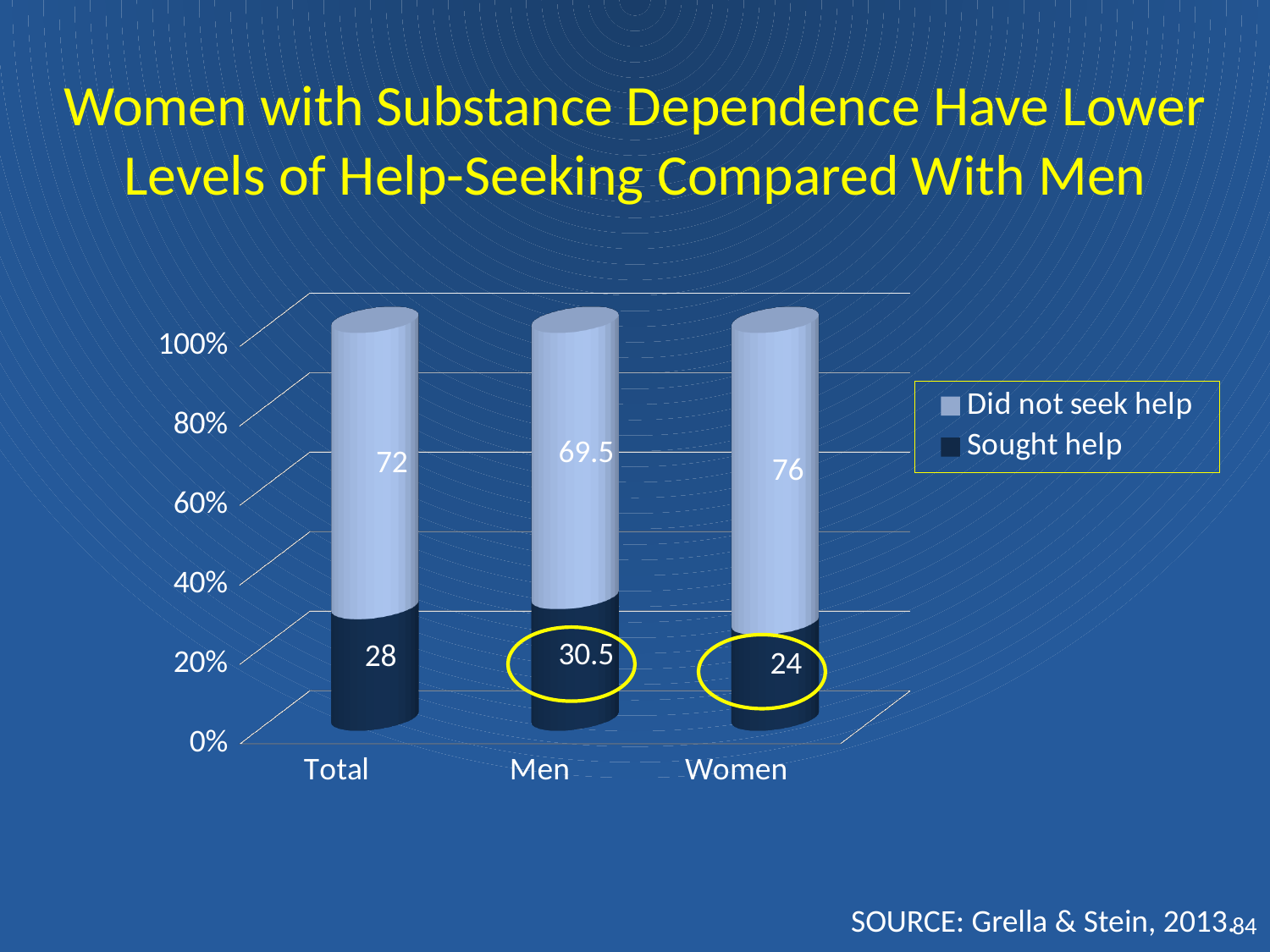
Which category has the highest value for Sought help? Men What is the difference between the Sought help values for Men and Women? 6.5 Which category has the lowest value for Sought help? Women Which is larger, the Did not seek help value for Women or for Men? Women What is the value for Sought help in the Men category? 30.5 How many categories are shown on the x axis? 3 Which series is shown in the darker colour in the legend? Sought help What kind of chart is shown on the slide? Stacked bar chart What is the value for Did not seek help in the Women category? 76 What is the total of the stacked bar for Men? 100 What is the value for Sought help in the Total category? 28 How many series does the legend list? 2